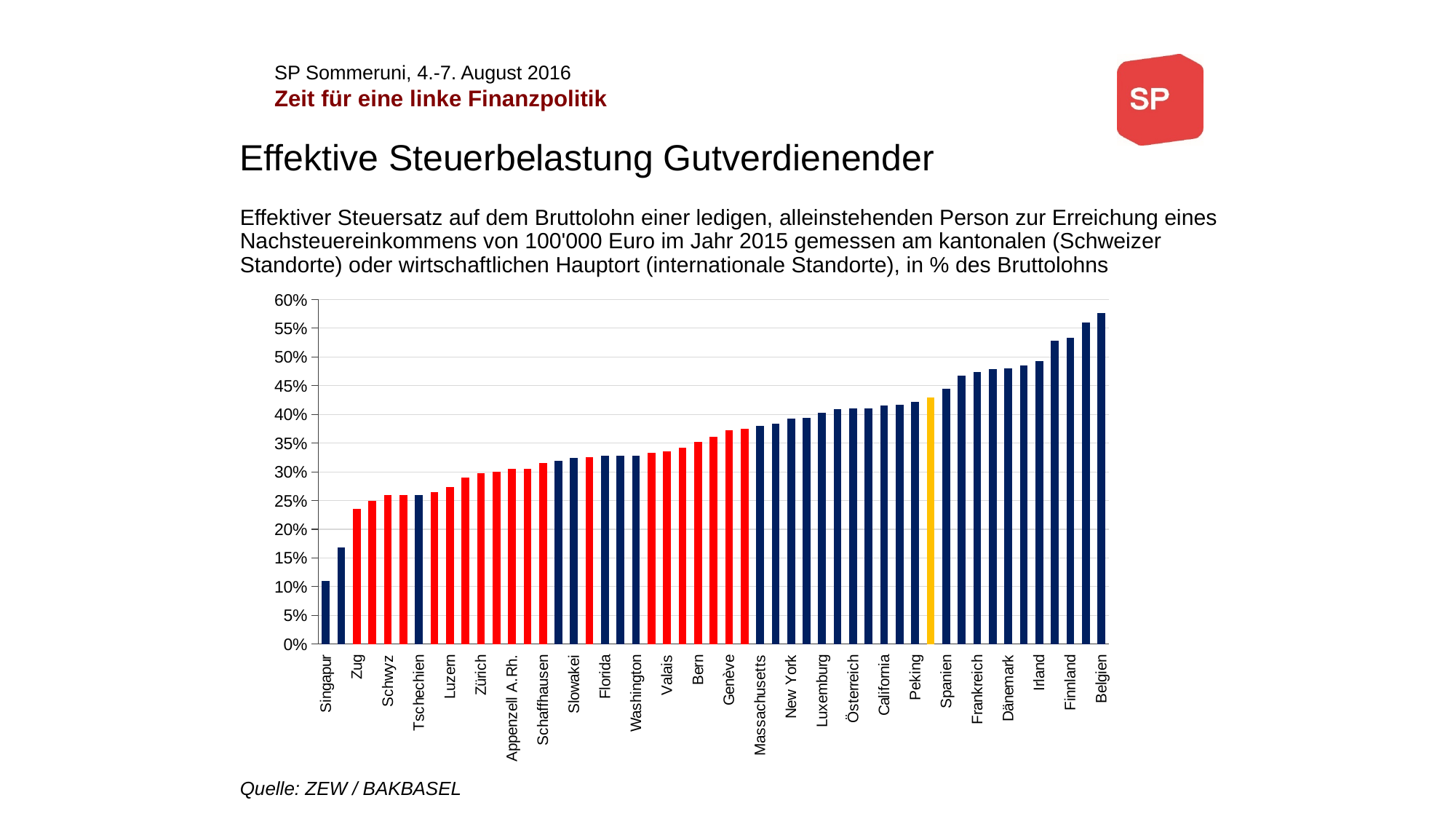
Is the value for Genève greater or less than 35%? greater Do the bar values rise or fall from left to right along the x axis? rise Is the value for Belgien greater or less than 55%? greater Is the value for Singapur greater or less than 15%? less What source is cited below the chart? ZEW / BAKBASEL Which labelled location has the highest effective tax rate? Belgien What kind of chart is shown on the slide? bar chart Which labelled location has the lowest effective tax rate? Singapur Which has the higher effective tax rate, Zug or Zürich? Zürich